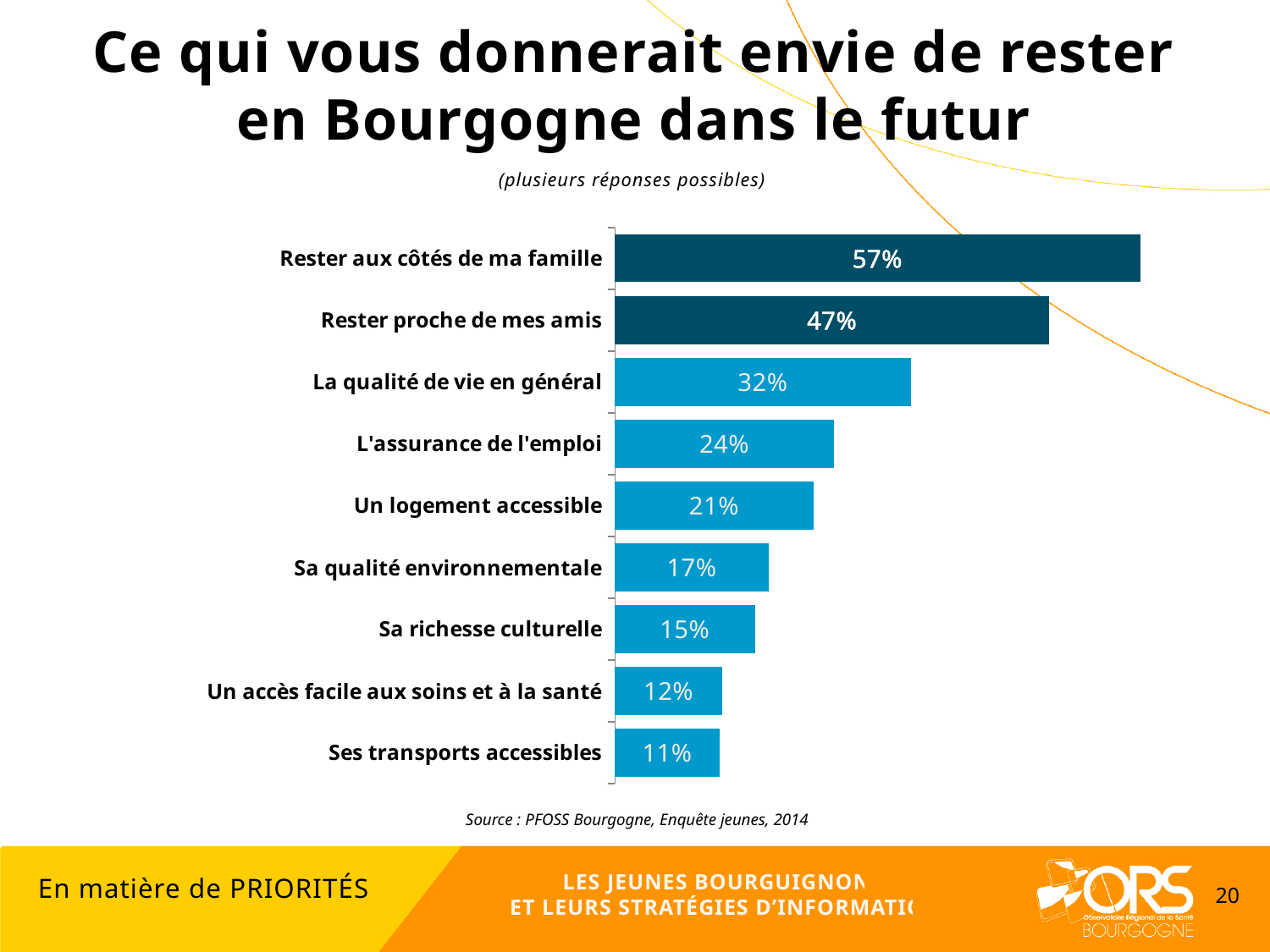
What is the value shown for "La qualité de vie en général"? 32% Which is larger: "Sa qualité environnementale" or "Un accès facile aux soins et à la santé"? Sa qualité environnementale What is the source cited below the chart? PFOSS Bourgogne, Enquête jeunes, 2014 What percentage of respondents chose "Rester aux côtés de ma famille"? 57% Which category has the lowest value? Ses transports accessibles Which category has the highest value? Rester aux côtés de ma famille How many categories are shown in the chart? 9 How many bars are shown in the darker blue colour? 2 What is the difference between "L'assurance de l'emploi" and "Sa richesse culturelle"? 9% What is the difference between "Rester aux côtés de ma famille" and "Rester proche de mes amis"? 10% What is the value shown for "Un logement accessible"? 21% What kind of chart is shown on the slide? Bar chart